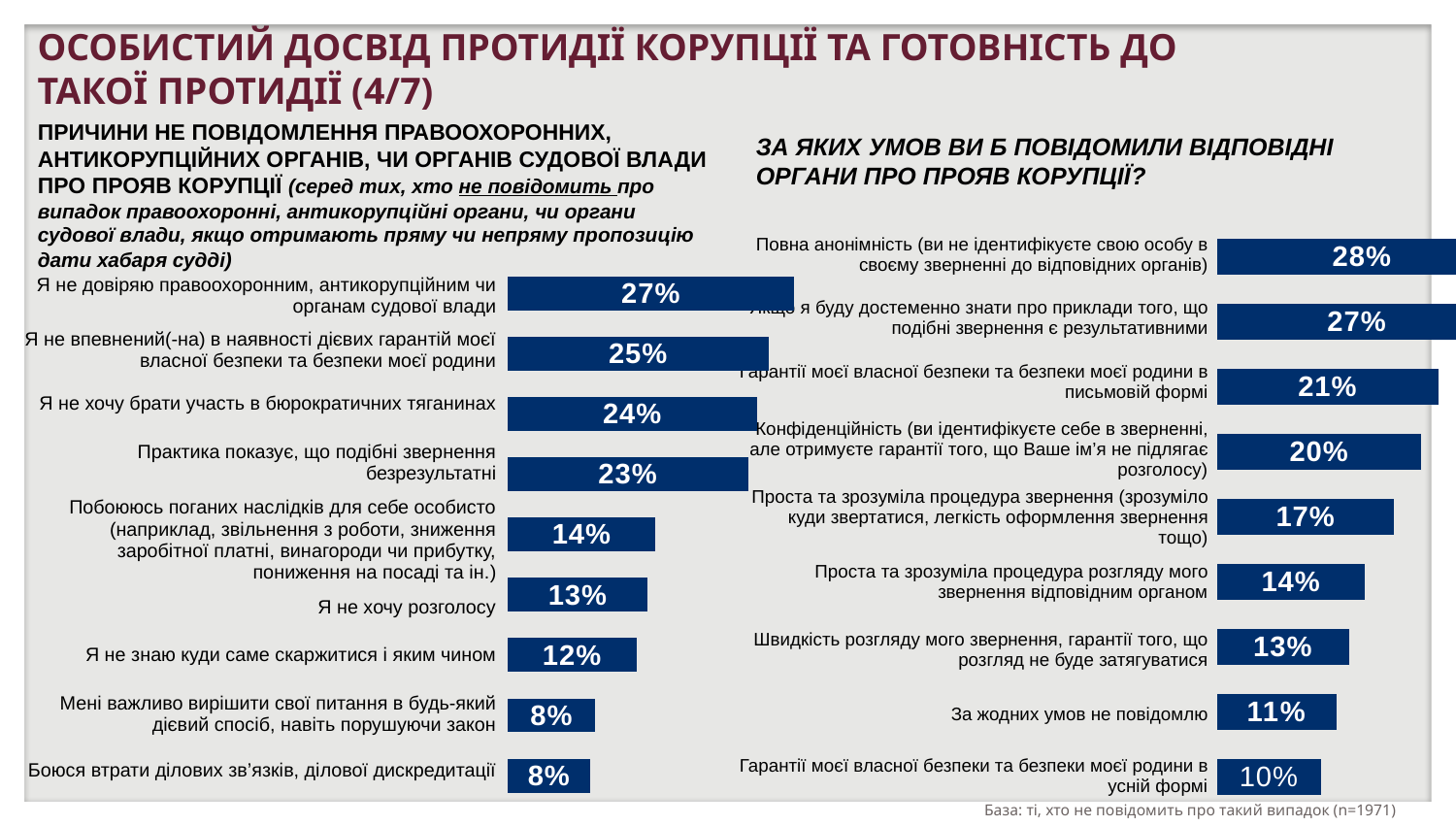
On the right chart, what percentage is shown for "Повна анонімність"? 28% On the left chart, what is the difference between "Я не довіряю правоохоронним, антикорупційним чи органам судової влади" and "Я не знаю куди саме скаржитися і яким чином"? 15% On the right chart, what is the difference between "Повна анонімність" and "Конфіденційність"? 8% On the left chart, what percentage is shown for "Я не хочу брати участь в бюрократичних тяганинах"? 24% On the right chart, which is larger: "Проста та зрозуміла процедура звернення" or "Швидкість розгляду мого звернення"? Проста та зрозуміла процедура звернення On the left chart, how many categories are plotted? 9 According to the note at the bottom of the slide, what is the sample size (n) for the right chart? n=1971 What type of chart is used on the right side of the slide? Bar chart On the right chart, what percentage is shown for "За жодних умов не повідомлю"? 11% On the left chart, what percentage is shown for "Я не хочу розголосу"? 13% On the right chart, which category has the lowest value? Гарантії моєї власної безпеки та безпеки моєї родини в усній формі On the left chart, which category has the highest value? Я не довіряю правоохоронним, антикорупційним чи органам судової влади